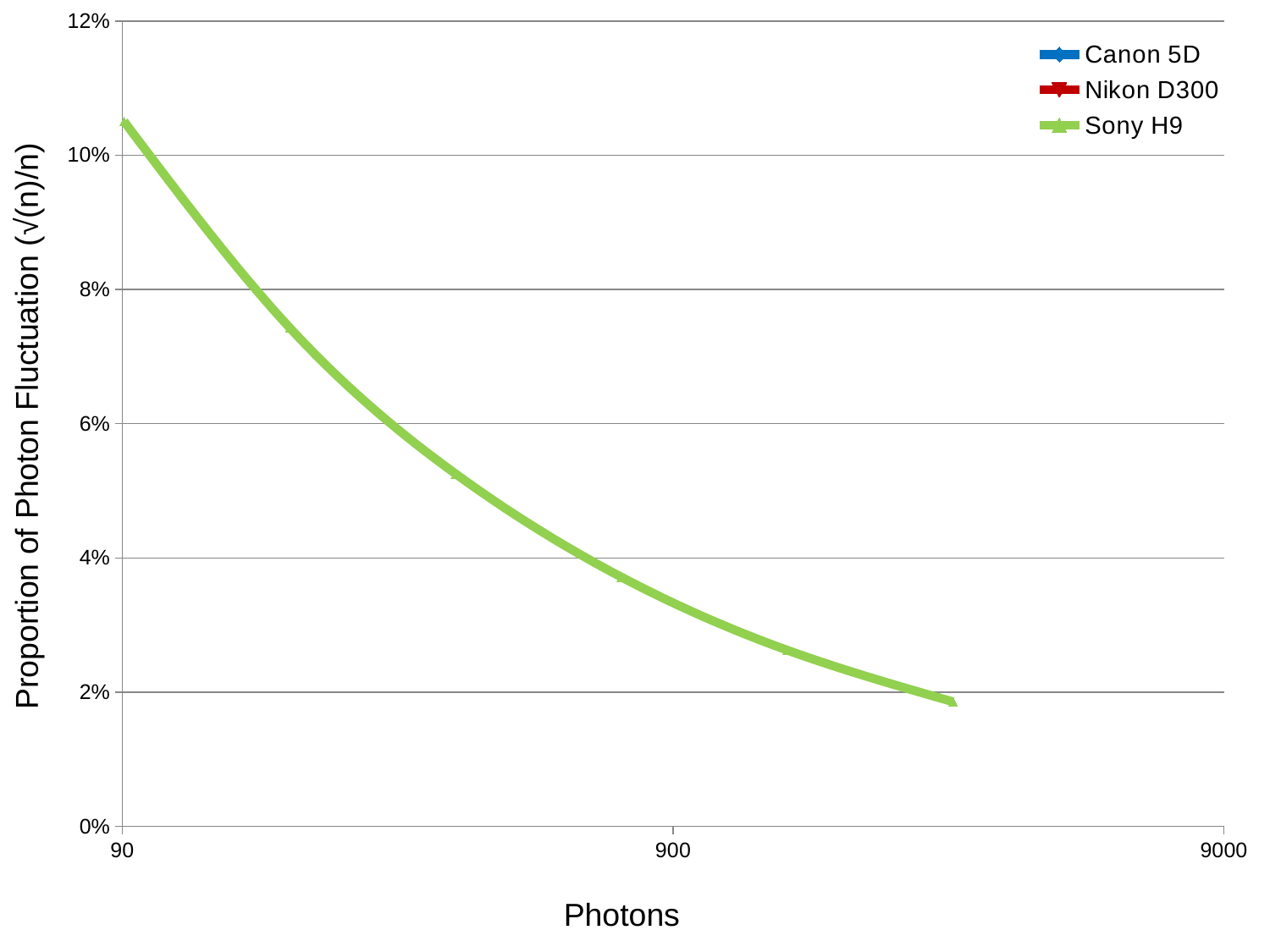
Do the plotted values rise or fall as the number of photons increases along the x axis? fall Is the value of the Sony H9 line at 900 photons greater or less than 2%? greater Is the value of the Sony H9 line at 90 photons greater or less than 10%? greater What kind of chart is shown on the slide? line chart Which is larger for the Sony H9 line: the value at 90 photons or the value at 900 photons? the value at 90 photons Is the value of the Sony H9 line at 900 photons greater or less than 4%? less What is the title of the x axis? Photons Which series are listed in the legend? Canon 5D, Nikon D300, Sony H9 What is the highest tick label shown on the y axis? 12% How many series does the legend list? 3